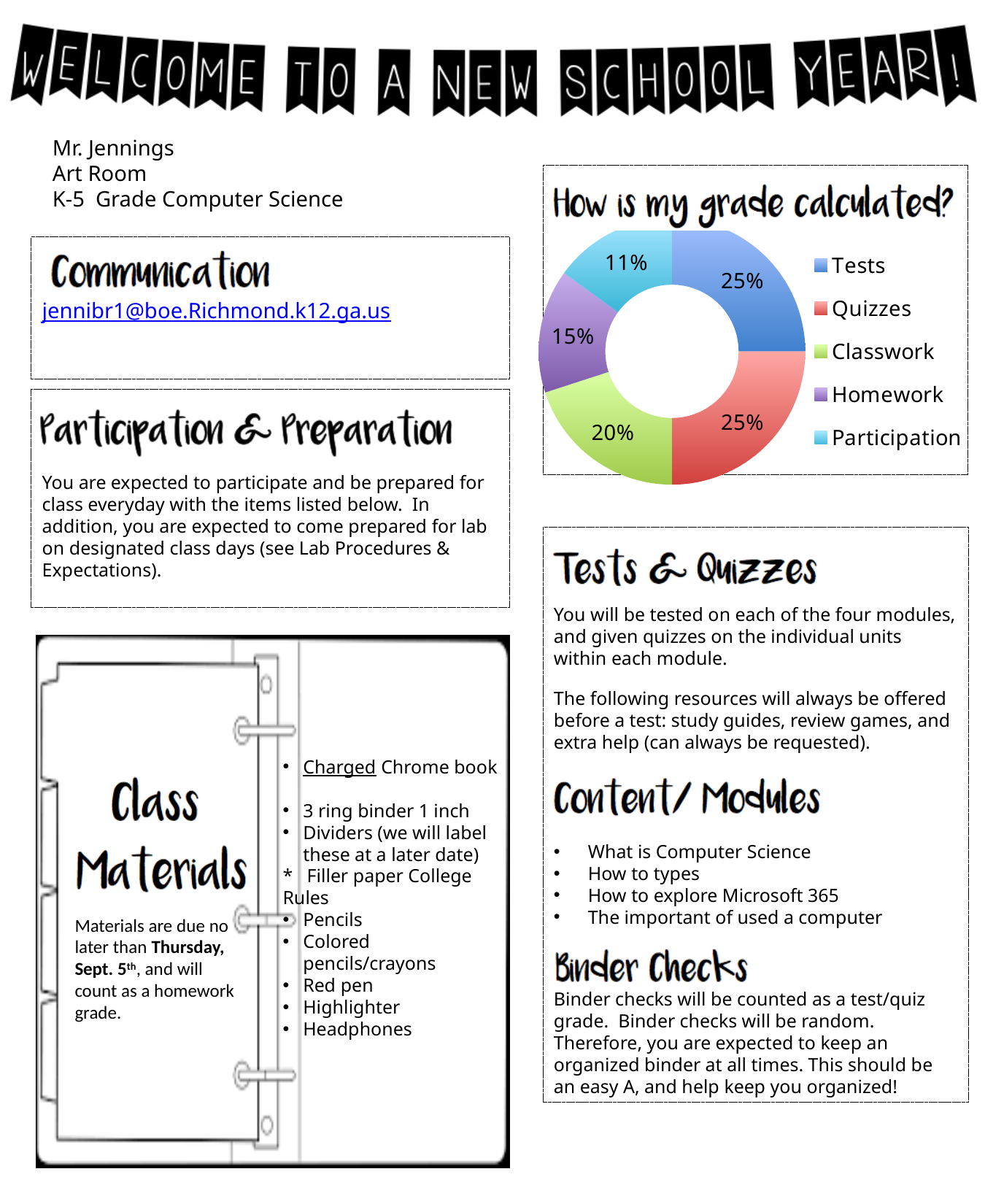
In the "How is my grade calculated?" chart, what percentage is Homework? 15% In the "How is my grade calculated?" chart, what is the difference between the Classwork and Participation percentages? 9% In the "How is my grade calculated?" chart, which colour represents Quizzes? Red In the "How is my grade calculated?" chart, which is larger, Classwork or Homework? Classwork What kind of chart is shown under "How is my grade calculated?"? Pie chart (doughnut) In the "How is my grade calculated?" chart, which category has the smallest share? Participation In the "How is my grade calculated?" chart, what percentage is Participation? 11% In the "How is my grade calculated?" chart, what percentage is Classwork? 20% In the "How is my grade calculated?" chart, what is the difference between the Tests and Homework percentages? 10% How many categories does the legend of the "How is my grade calculated?" chart list? 5 In the "How is my grade calculated?" chart, what percentage is Tests? 25% In the "How is my grade calculated?" chart, which category is shown in purple? Homework